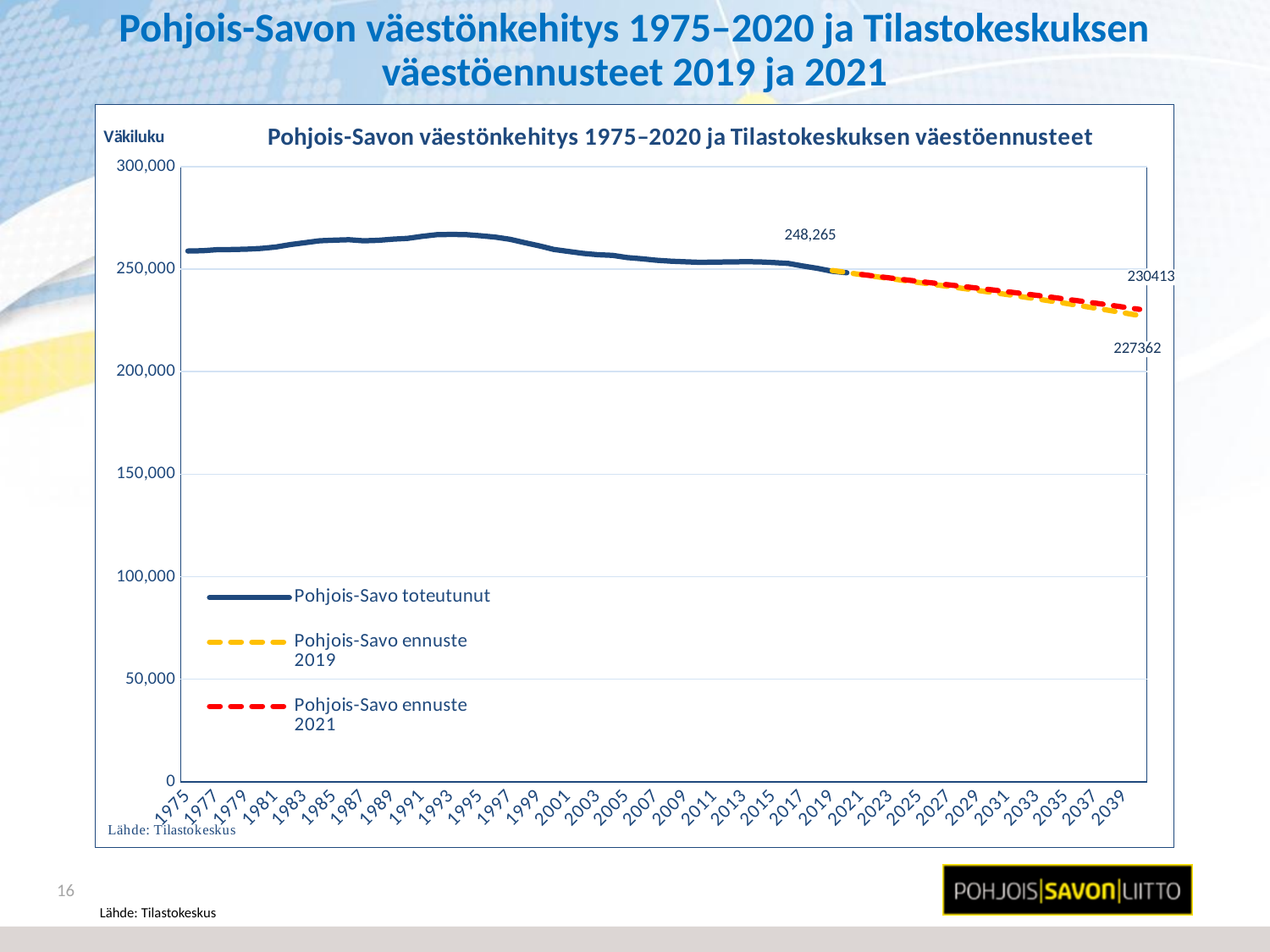
What is the labelled value at the end of the Pohjois-Savo toteutunut series? 248,265 What is the labelled end value of the Pohjois-Savo ennuste 2019 series? 227362 Does the Pohjois-Savo toteutunut series rise or fall between 2000 and 2020? fall What kind of chart is shown on the slide? line chart Is the value of the Pohjois-Savo ennuste 2019 series in 2035 greater or less than 250,000? less Which forecast series ends at a higher value, Pohjois-Savo ennuste 2019 or Pohjois-Savo ennuste 2021? Pohjois-Savo ennuste 2021 What is the labelled end value of the Pohjois-Savo ennuste 2021 series? 230413 What is the difference between the last actual value (248,265) and the end value of the ennuste 2021 series (230413)? 17852 What label is shown on the vertical axis of the chart? Väkiluku How many series does the chart legend list? 3 Is the value of the Pohjois-Savo toteutunut series in 1993 greater or less than 250,000? greater What is the difference between the end values of the ennuste 2021 (230413) and ennuste 2019 (227362) series? 3051